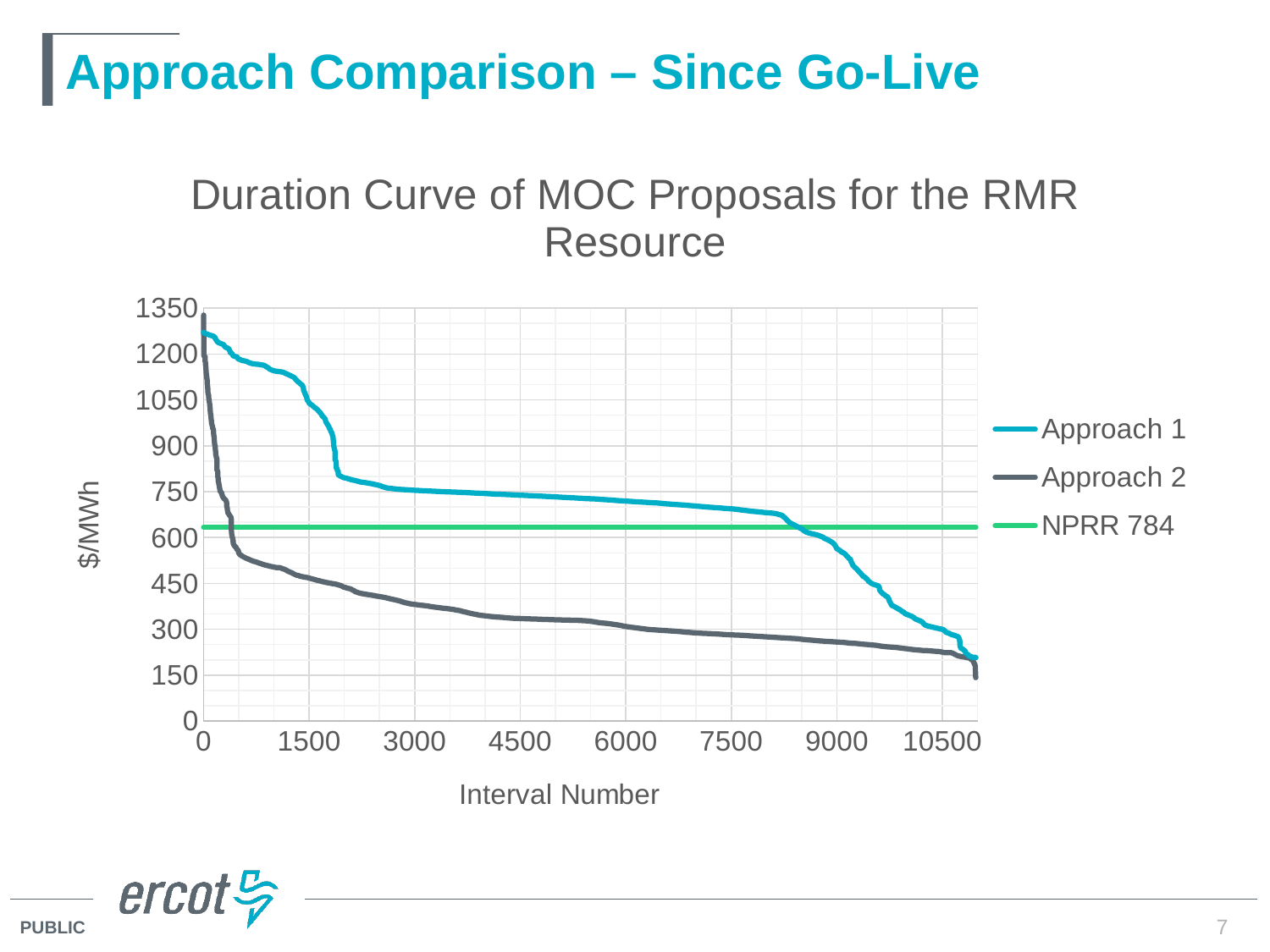
What are the series names listed in the legend? Approach 1, Approach 2, NPRR 784 Is the value of the NPRR 784 line greater or less than 750 $/MWh? less Is the value of Approach 1 at interval number 4500 greater or less than 600 $/MWh? greater What kind of chart is shown on the slide? Line chart At interval number 9000, which series has the higher value, Approach 1 or Approach 2? Approach 1 At interval number 3000, which series has the higher value, Approach 1 or Approach 2? Approach 1 Is the value of Approach 2 at interval number 4500 greater or less than 450 $/MWh? less Does the NPRR 784 line rise, fall, or stay flat across the interval numbers? Stay flat Does the Approach 1 line rise or fall as the interval number increases? Fall What is the title of the chart? Duration Curve of MOC Proposals for the RMR Resource Does the Approach 2 line rise or fall as the interval number increases? Fall How many series does the legend list? 3